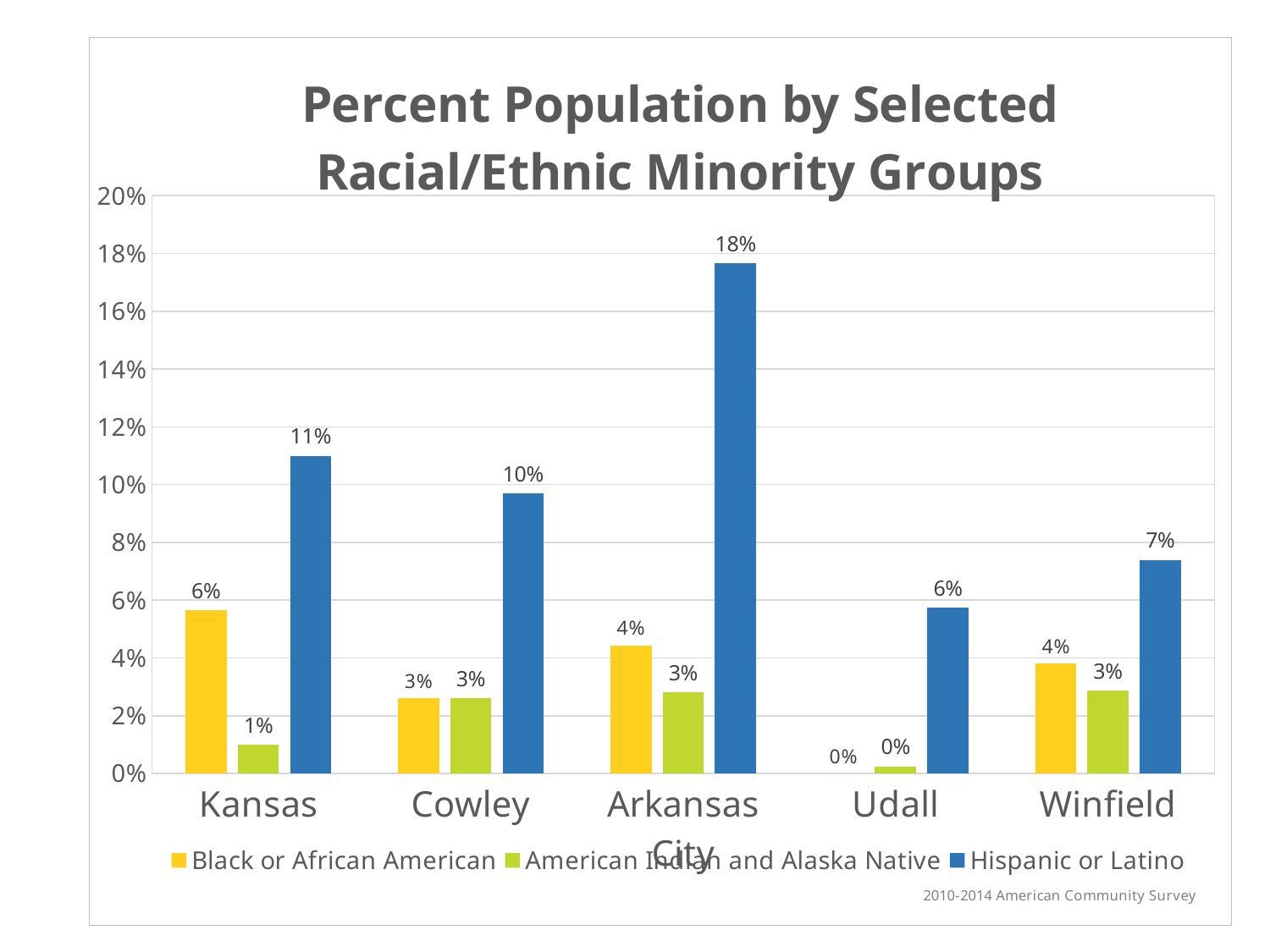
What is the Hispanic or Latino value for Arkansas City? 18% Which category has the highest Hispanic or Latino value? Arkansas City What is the Hispanic or Latino value for Udall? 6% Is the Hispanic or Latino value for Cowley greater or less than 8%? greater Which category has the lowest Hispanic or Latino value? Udall What is the Black or African American value for Kansas? 6% How many categories are shown on the x axis? 5 What is the difference between the Hispanic or Latino values for Arkansas City and Kansas? 7% What kind of chart is shown on the slide? Bar chart Which is larger for Kansas: the Black or African American value or the Hispanic or Latino value? Hispanic or Latino How many series does the legend list? 3 What is the American Indian and Alaska Native value for Winfield? 3%